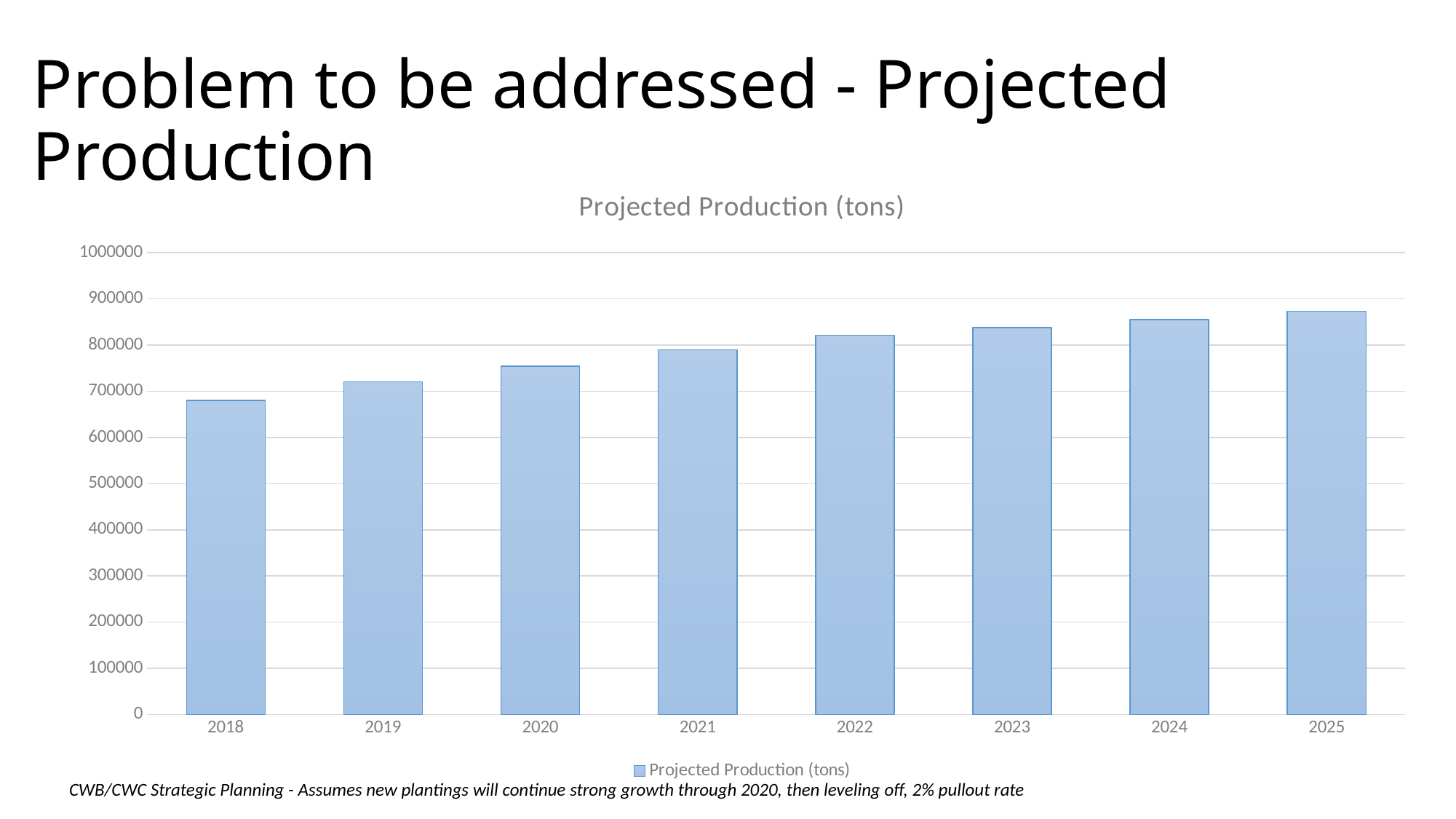
Is the projected production for 2022 greater or less than 800000? greater What kind of chart is shown on the slide? bar chart Is the projected production for 2025 greater or less than 900000? less How many years are shown on the x axis of the chart? 8 Which year has the highest projected production? 2025 Which year has the lowest projected production? 2018 Do the projected production values rise or fall from 2018 to 2025? rise Is the projected production for 2018 greater or less than 700000? less How many series does the legend list? 1 Which year has the larger projected production, 2020 or 2024? 2024 What is the title of the chart? Projected Production (tons)